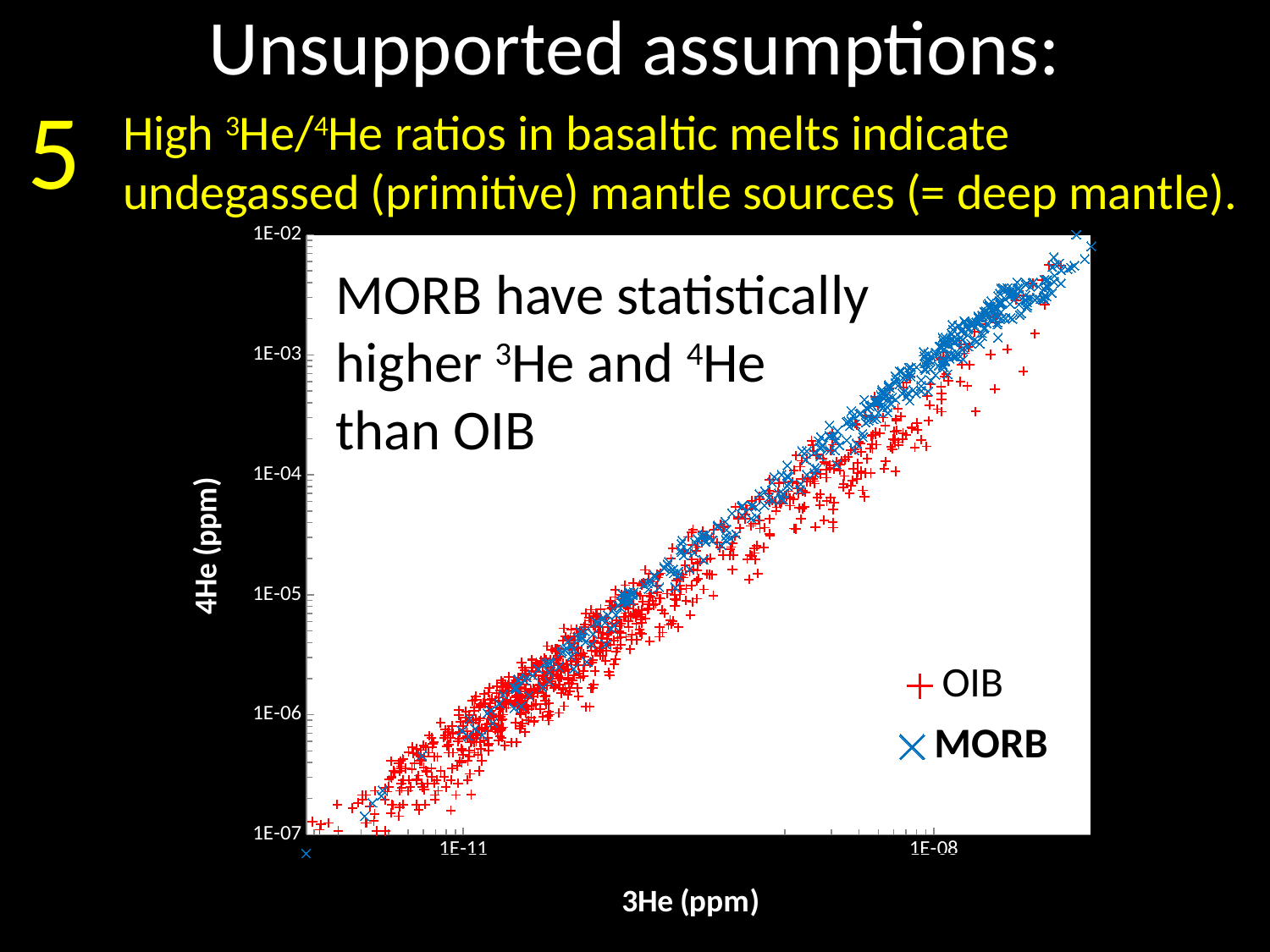
What is the label of the x axis of the chart? 3He (ppm) What is the label of the y axis of the chart? 4He (ppm) What are the two series named in the chart's legend? OIB and MORB What kind of chart is shown on the slide? scatter plot According to the text on the chart, which group has statistically higher 3He and 4He, MORB or OIB? MORB What is the highest tick value shown on the y axis of the chart? 1E-02 As 3He increases along the x axis, do the 4He values rise or fall? rise How many series does the chart's legend list? 2 What is the lowest tick value shown on the y axis of the chart? 1E-07 Which series, OIB or MORB, reaches the highest 4He values on the chart? MORB